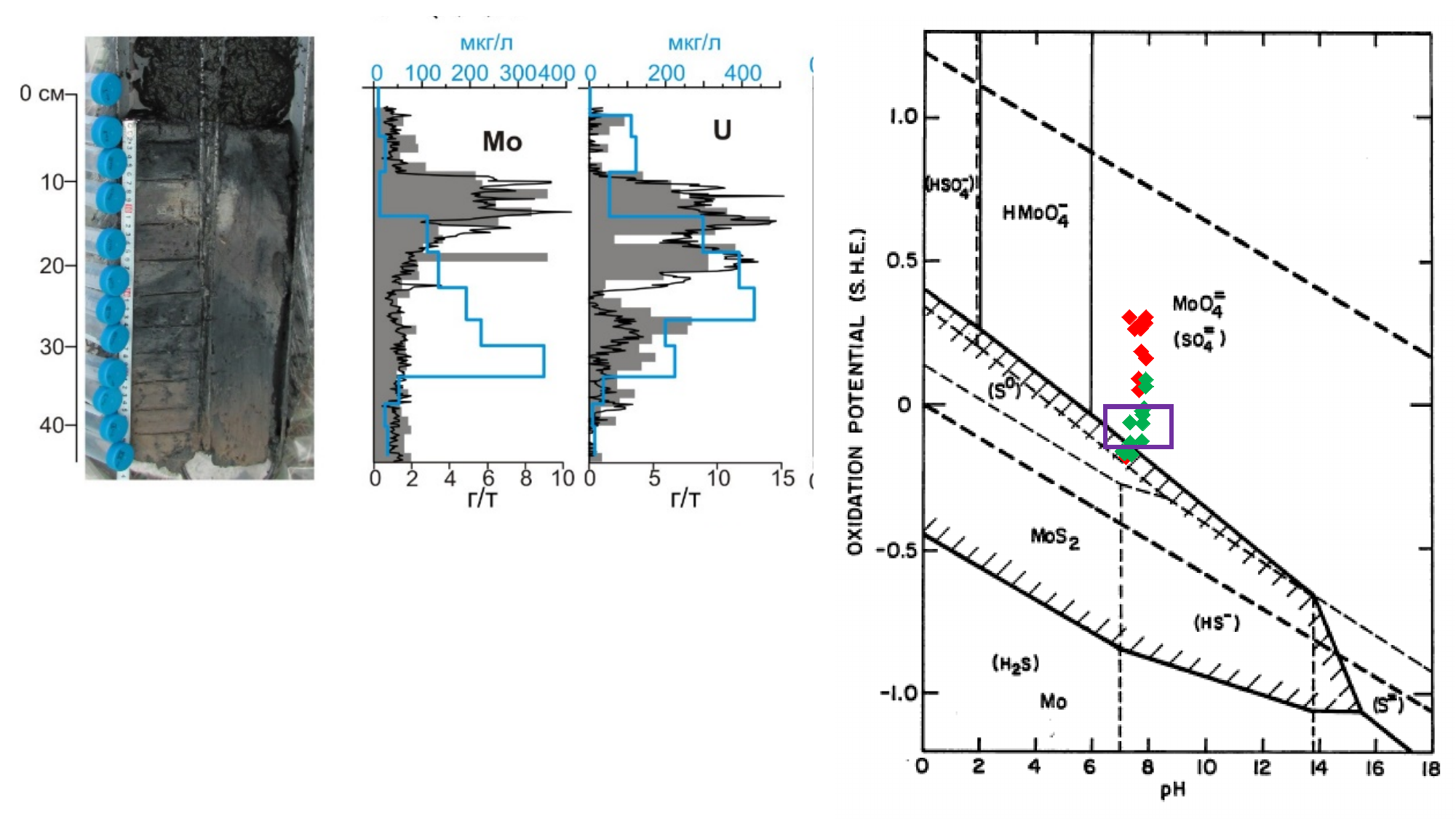
On the right diagram, are the plotted diamond points at a pH greater or less than 6? greater What is the x-axis label of the Eh-pH diagram on the right of the slide? pH On the right diagram, are the red diamond points at an oxidation potential greater or less than 0.5? less On the right diagram, do the stability boundary lines rise or fall as pH increases? fall How many colours of diamond markers are plotted on the right diagram? 2 Which two elements are shown in the depth profiles in the middle of the slide? Mo and U On the right diagram, which colour of diamond points lies at a higher oxidation potential, red or green? red On the right diagram, are the plotted diamond points at a pH greater or less than 10? less